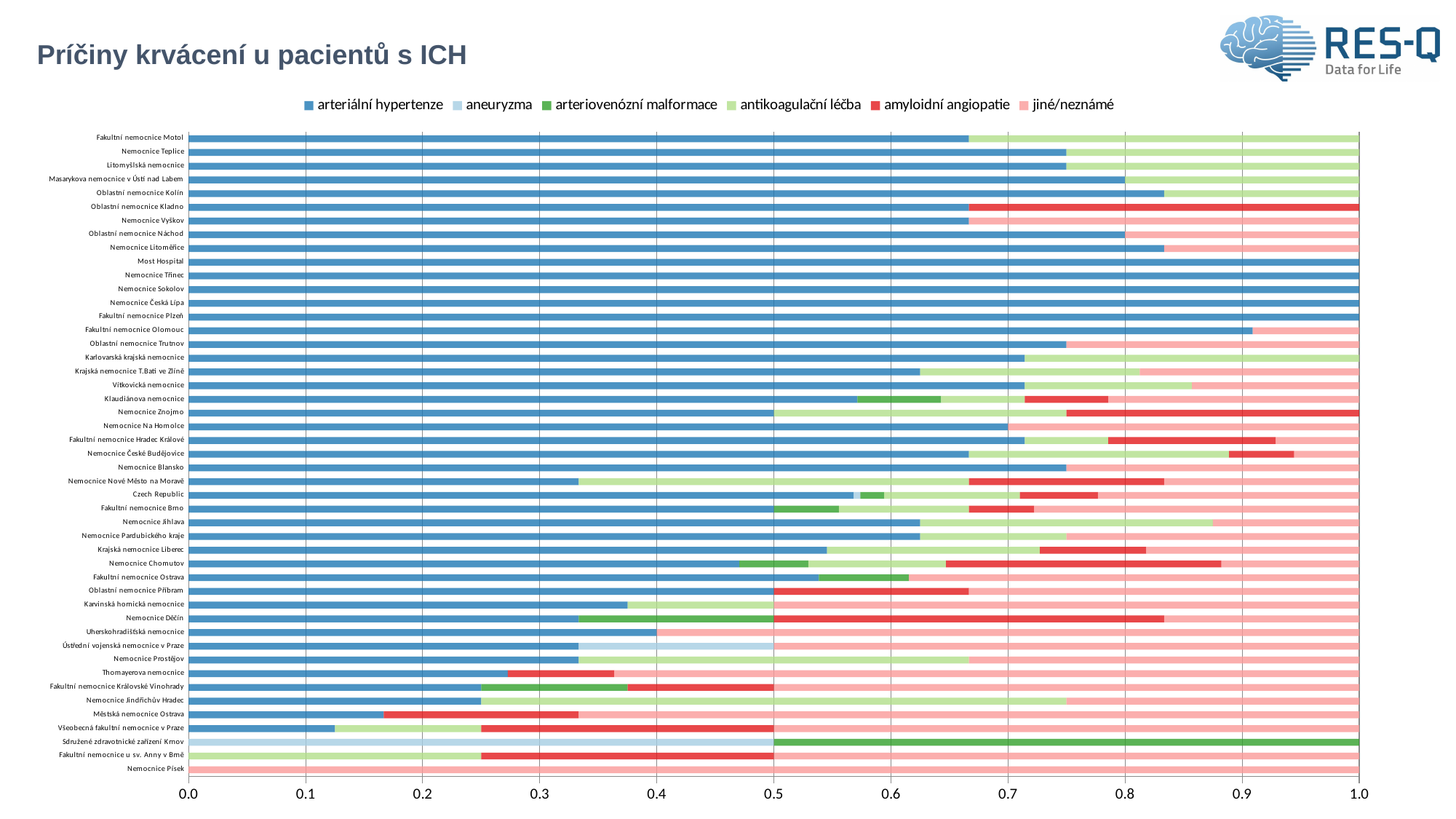
What kind of chart is shown on the slide? stacked bar chart What is the value of arteriální hypertenze for Uherskohradišťská nemocnice? 0.4 How many series does the legend list? 6 How many hospitals (categories) are plotted on the chart? 47 Is the value of arteriální hypertenze for Všeobecná fakultní nemocnice v Praze greater or less than 0.2? less What is the value of jiné/neznámé for Nemocnice Písek? 1.0 Is the value of arteriální hypertenze for Fakultní nemocnice Motol greater or less than 0.6? greater What colour represents amyloidní angiopatie in the legend? red What is the value of aneuryzma for Sdružené zdravotnické zařízení Krnov? 0.5 What is the value of arteriální hypertenze for Most Hospital? 1.0 What is the value of arteriální hypertenze for Nemocnice Na Homolce? 0.7 Which has the larger arteriální hypertenze share, Fakultní nemocnice Motol or Nemocnice Nové Město na Moravě? Fakultní nemocnice Motol